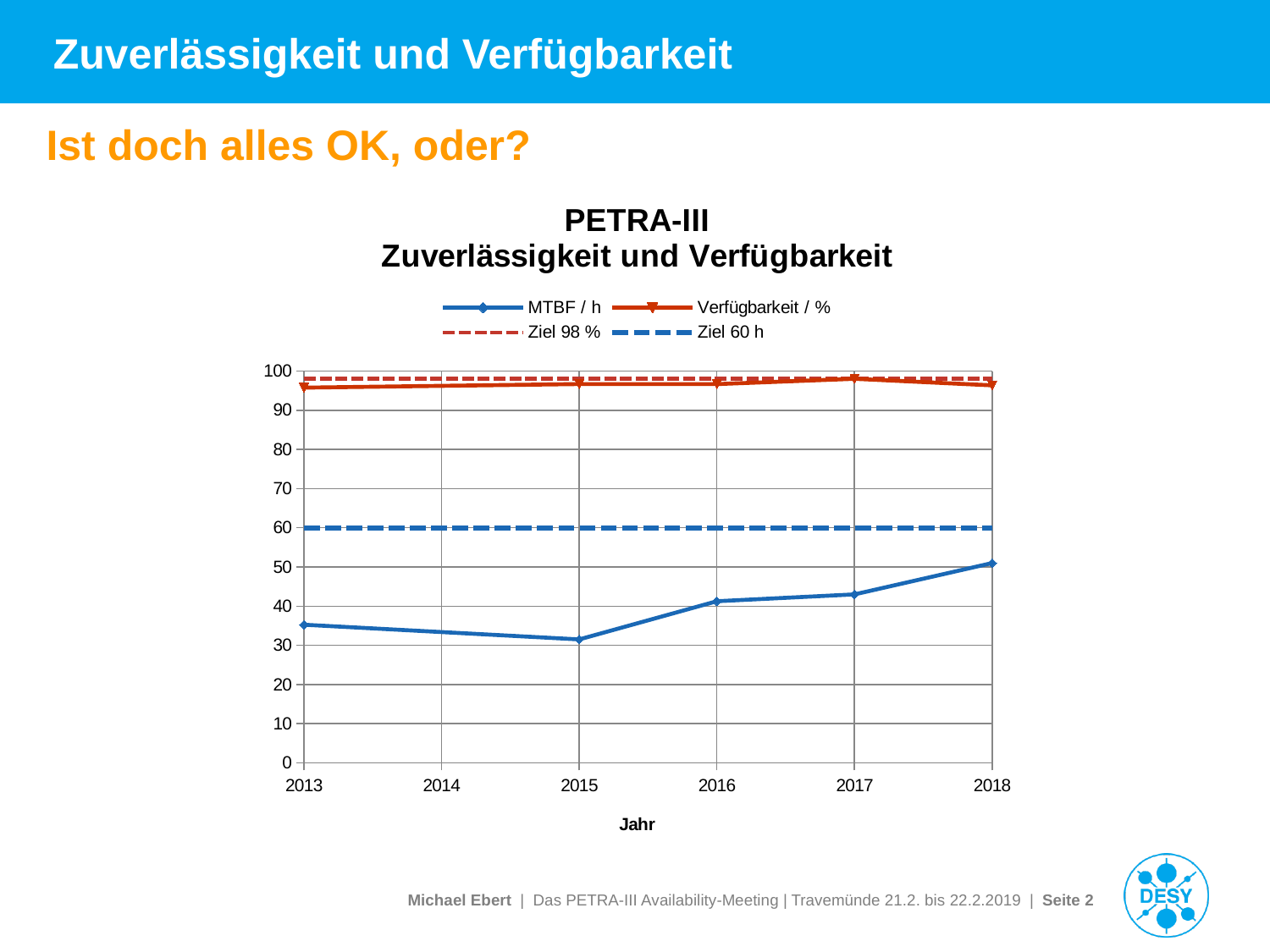
In which year is the MTBF / h value lowest? 2015 Does the MTBF / h line rise or fall from 2015 to 2018? rise Which is larger, the MTBF / h value for 2018 or for 2013? 2018 How many years are shown on the x axis of the chart? 6 What is the title of the chart? PETRA-III Zuverlässigkeit und Verfügbarkeit What is the label of the x axis of the chart? Jahr How many series does the chart legend list? 4 In which year is the MTBF / h value highest? 2018 Is the MTBF / h value for 2018 greater or less than 60? less Is the Verfügbarkeit / % value for 2013 greater or less than 90? greater Is the MTBF / h value for 2015 greater or less than 40? less What kind of chart is shown on the slide? line chart